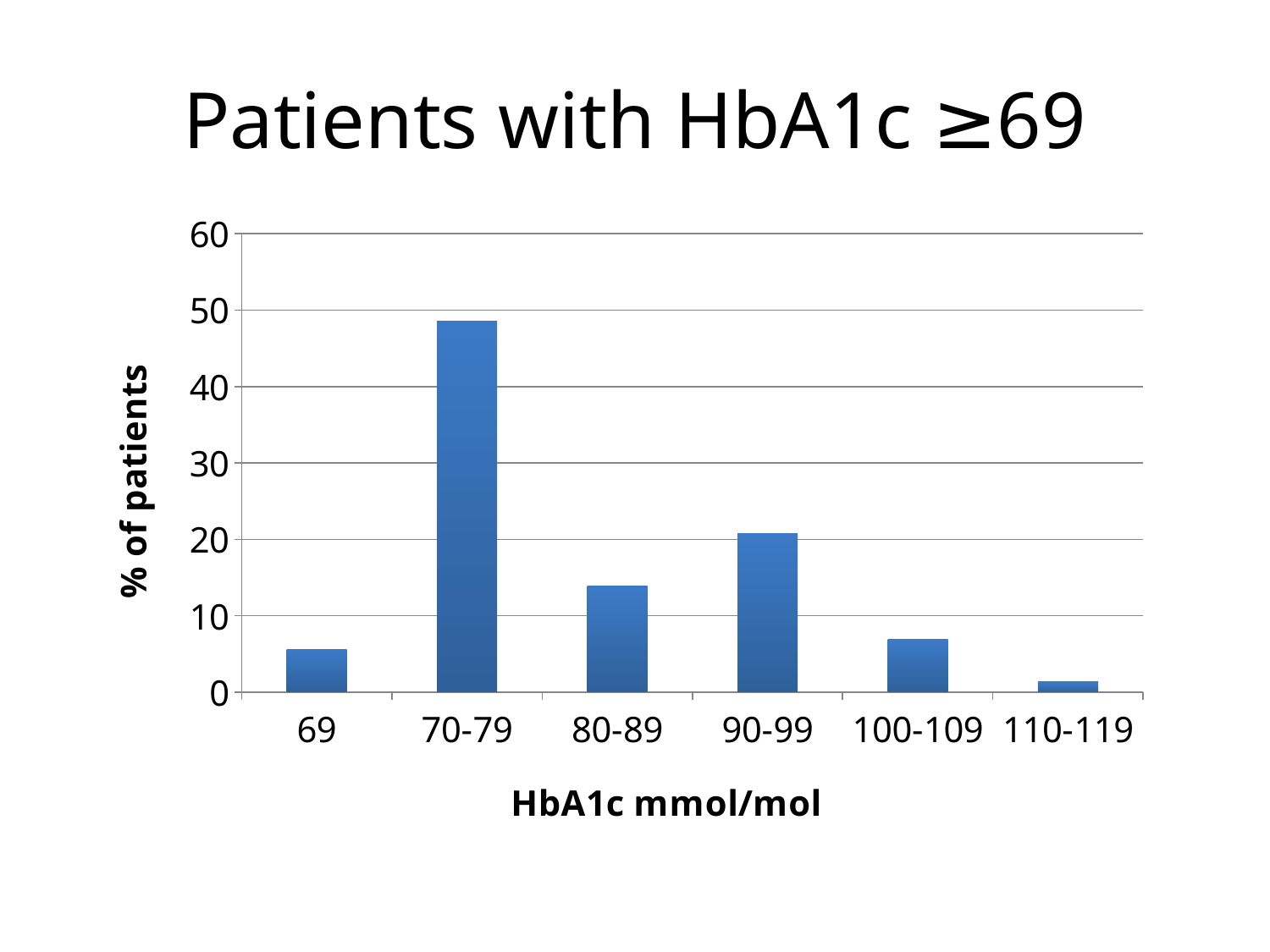
What is the title of the chart? Patients with HbA1c ≥69 Which has a higher percentage of patients, 90-99 or 80-89? 90-99 What is the label of the y axis? % of patients Is the value for 90-99 greater or less than 30? less What kind of chart is shown on the slide? bar chart Which HbA1c category has the highest percentage of patients? 70-79 Which HbA1c category has the lowest percentage of patients? 110-119 How many HbA1c categories are shown on the x axis? 6 Is the value for 70-79 greater or less than 40? greater Is the value for 110-119 greater or less than 10? less